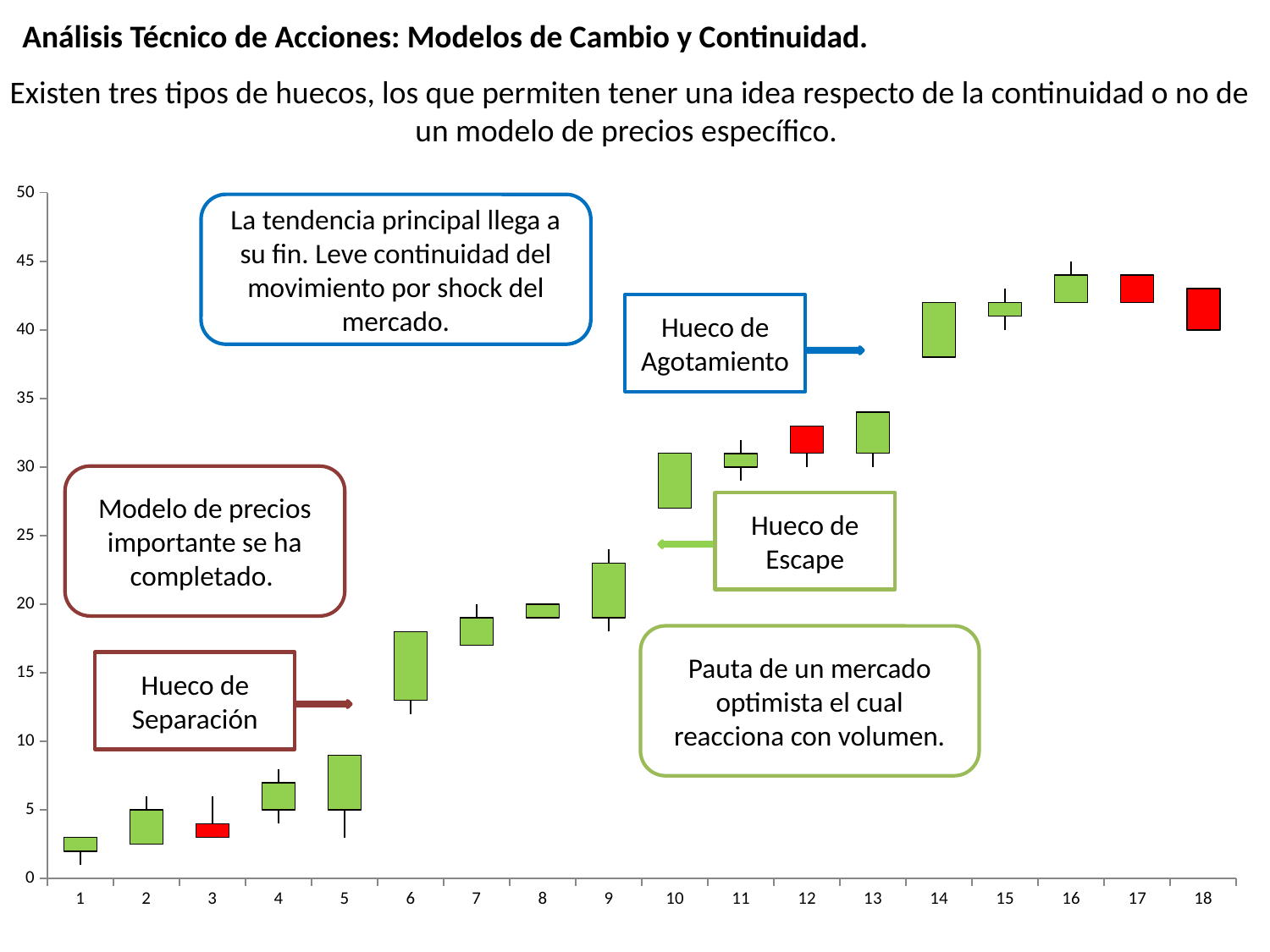
What is the highest value shown on the y axis of the chart? 50 How many red candles are there on the chart? 4 Is the candle for period 10 greater or less than 25? greater Is the candle for period 1 greater or less than 5? less Is the candle for period 18 greater or less than 35? greater Which period has the lowest candle on the chart? 1 What kind of chart is shown on the slide? Candlestick chart Do the prices in the chart generally rise or fall from period 1 to period 18? Rise How many periods are shown along the x axis of the chart? 18 What are the three types of gaps (huecos) labelled on the chart? Hueco de Separación, Hueco de Escape, Hueco de Agotamiento